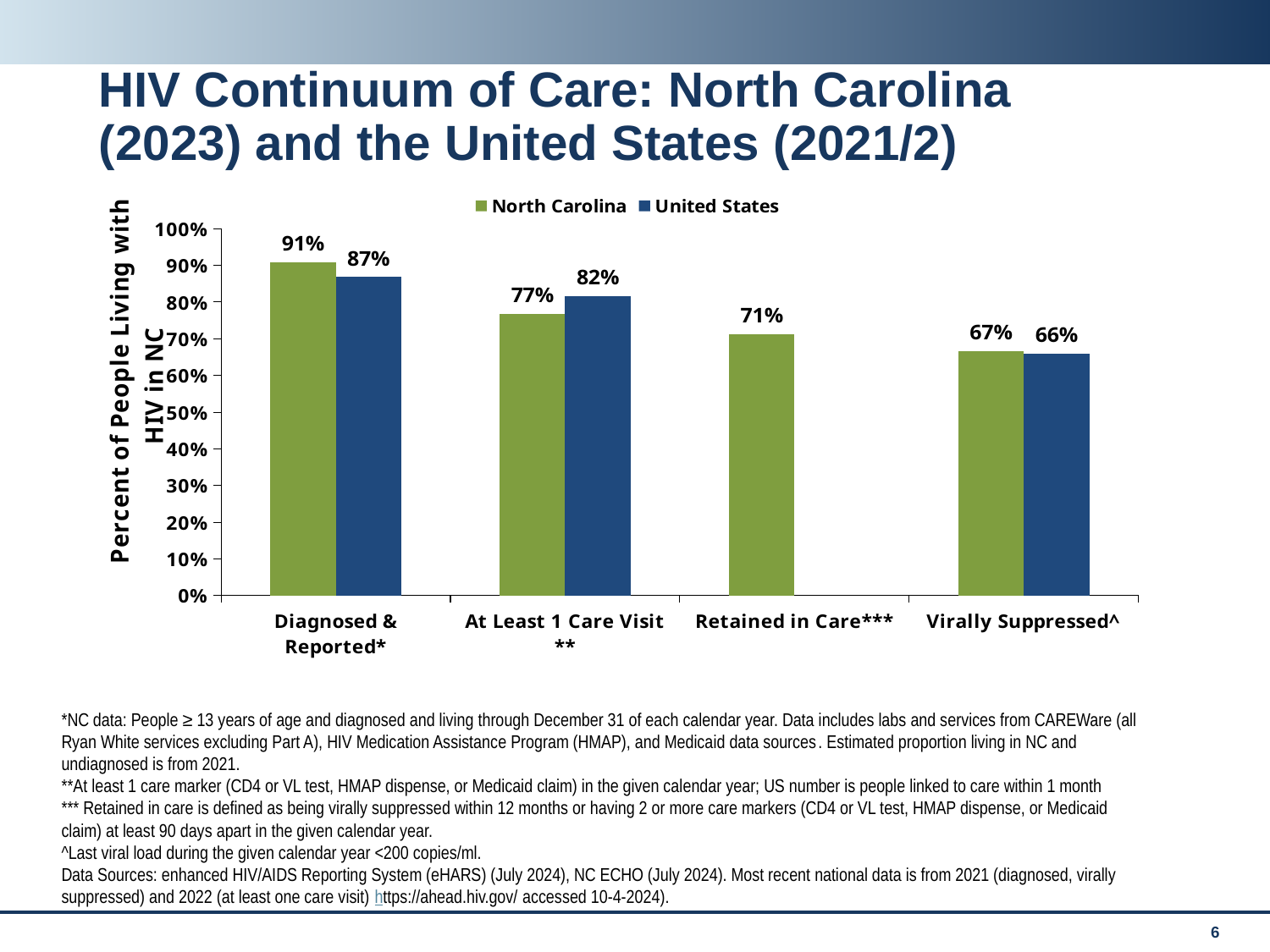
What is the difference between the North Carolina and United States values for Diagnosed & Reported*? 4% How many series does the legend list? 2 How many categories are shown on the x axis? 4 Do the North Carolina values rise or fall from left to right across the categories? Fall Which is larger for At Least 1 Care Visit**: North Carolina or United States? United States What kind of chart is shown on the slide? Bar chart What is the United States value for At Least 1 Care Visit**? 82% Which category has the lowest North Carolina value? Virally Suppressed^ What is the North Carolina value for Retained in Care***? 71% What is the North Carolina value for Diagnosed & Reported*? 91% What is the United States value for Virally Suppressed^? 66% Which category has the highest North Carolina value? Diagnosed & Reported*